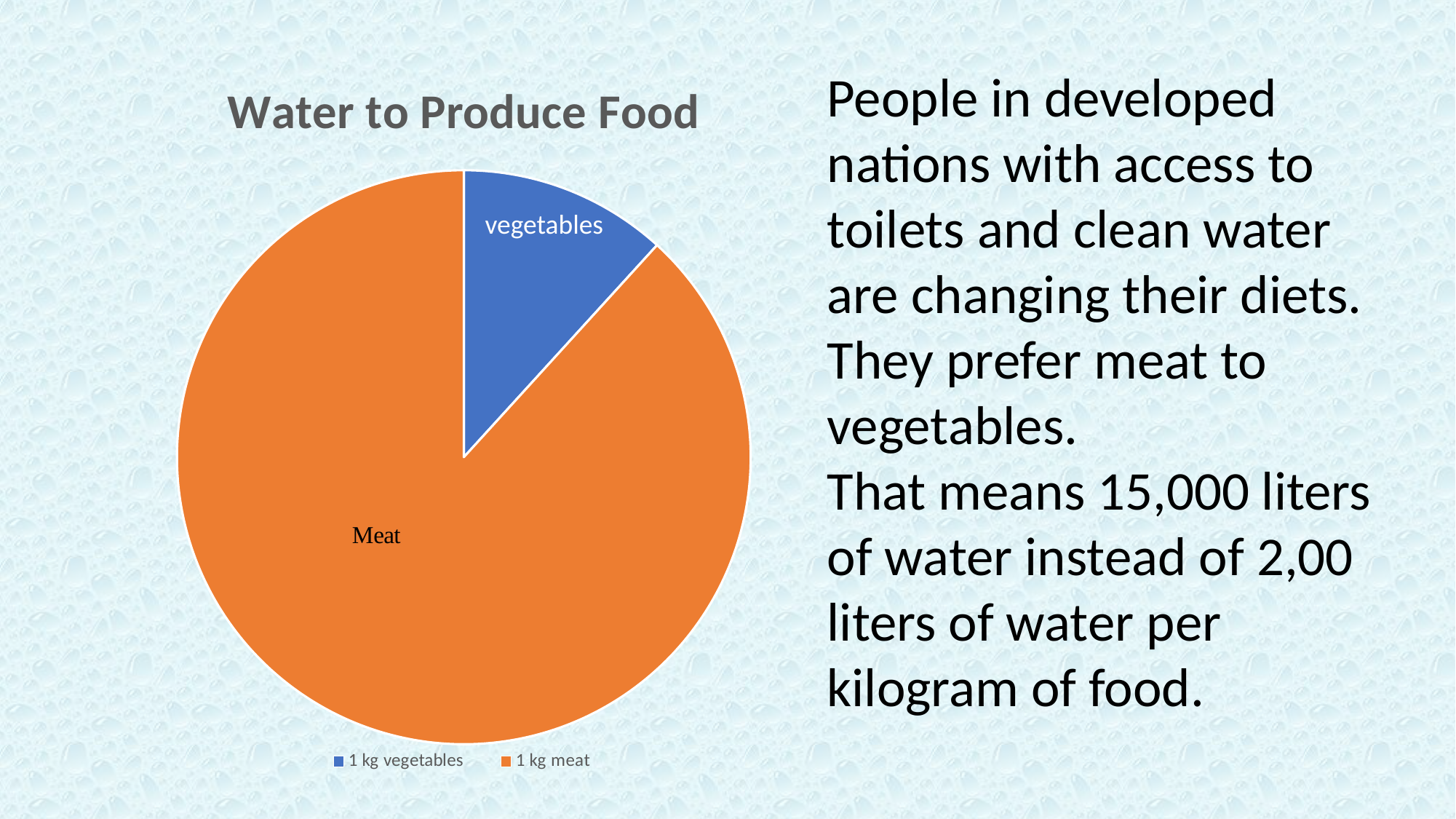
Which category takes up the smallest share of the pie chart? vegetables What colour is the Meat slice in the pie chart? orange What kind of chart is shown on the slide? pie chart Which slice is larger, Meat or vegetables? Meat How many entries does the chart legend list? 2 How many slices does the pie chart have? 2 Is the Meat slice more or less than half of the pie? more Which category takes up the largest share of the pie chart? Meat What is the title of the chart? Water to Produce Food